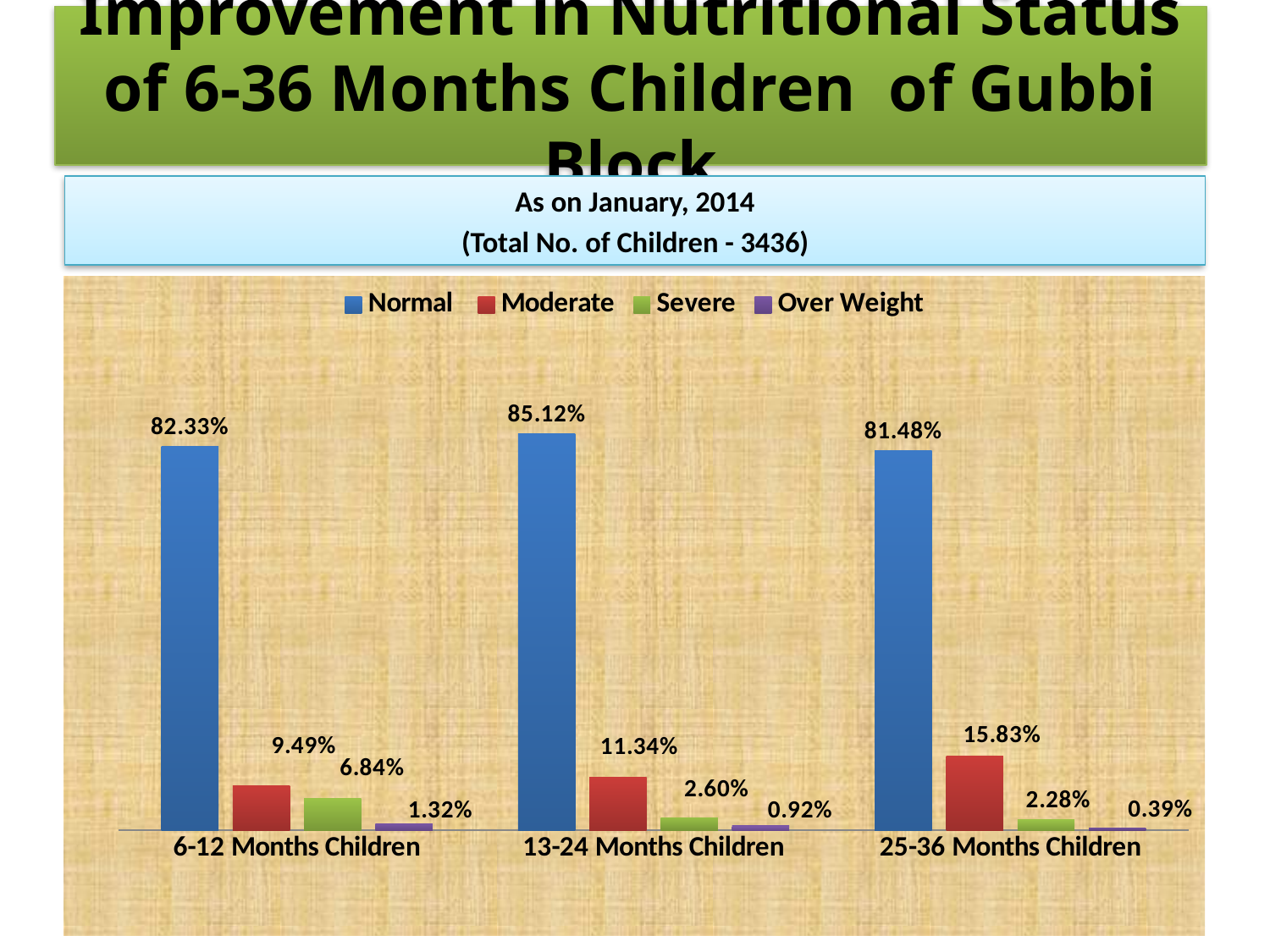
What is the Severe percentage for 13-24 Months Children? 2.60% What type of chart is shown on the slide? Bar chart What is the Over Weight percentage for 6-12 Months Children? 1.32% Which is larger: the Severe percentage for 6-12 Months Children or for 25-36 Months Children? 6-12 Months Children What is the difference between the Moderate percentages for 25-36 Months Children and 6-12 Months Children? 6.34% Which age group has the lowest Over Weight percentage? 25-36 Months Children What is the total number of children stated on the slide? 3436 How many age-group categories are shown on the x axis? 3 How many series does the legend list? 4 What is the Normal percentage for 6-12 Months Children? 82.33% Which age group has the highest Normal percentage? 13-24 Months Children What is the Moderate percentage for 25-36 Months Children? 15.83%